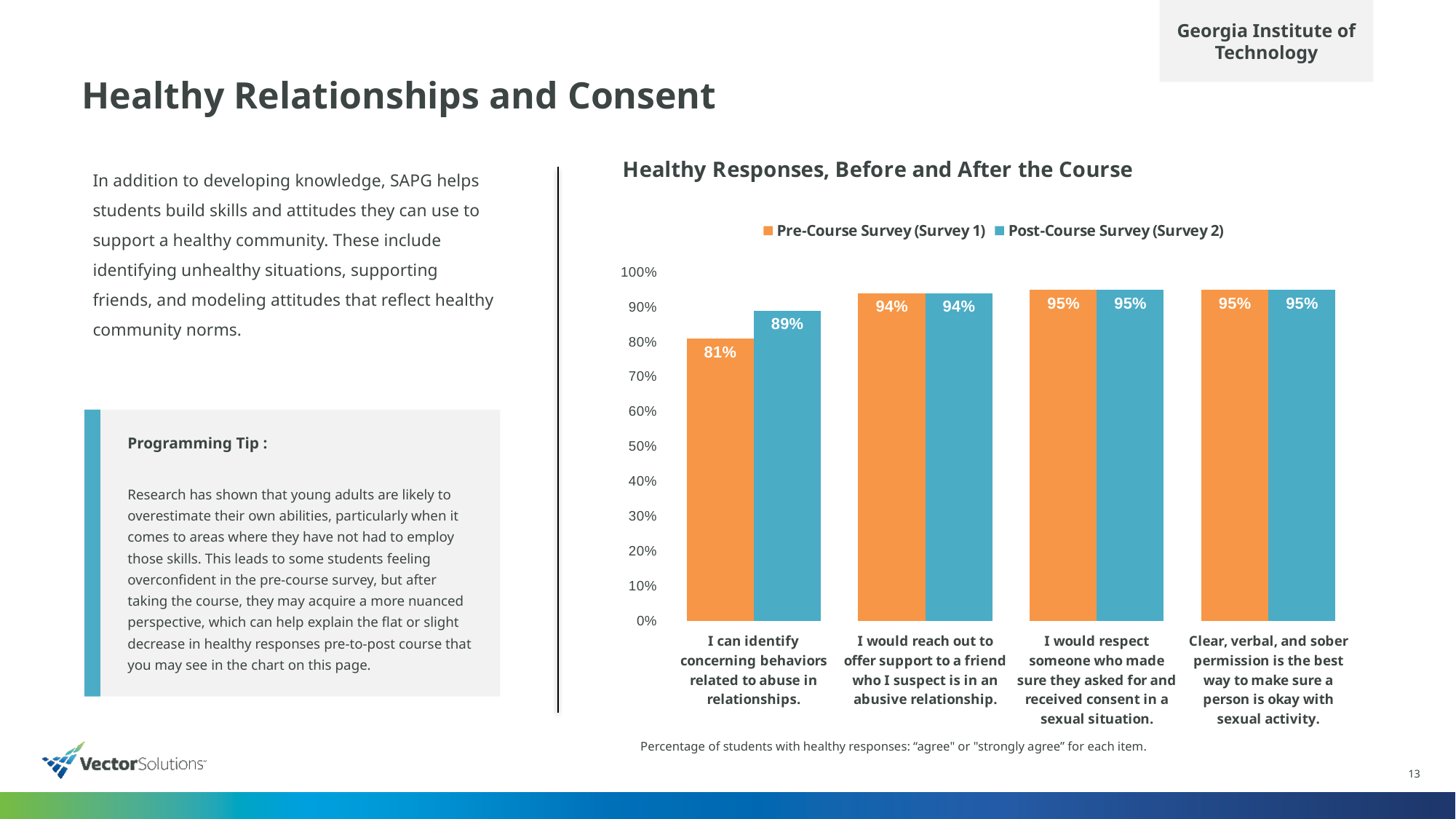
Which colour represents the Post-Course Survey (Survey 2) series in the chart? Blue What kind of chart is shown on the slide? Bar chart For "I can identify concerning behaviors related to abuse in relationships.", which is larger: the Pre-Course Survey value or the Post-Course Survey value? Post-Course Survey (Survey 2) How many categories are shown on the x axis of the chart? 4 What is the Pre-Course Survey (Survey 1) value for "I can identify concerning behaviors related to abuse in relationships."? 81% What is the title of the chart? Healthy Responses, Before and After the Course What is the Post-Course Survey (Survey 2) value for "I would reach out to offer support to a friend who I suspect is in an abusive relationship."? 94% What is the difference between the Post-Course and Pre-Course values for "I can identify concerning behaviors related to abuse in relationships."? 8% What is the Pre-Course Survey (Survey 1) value for "Clear, verbal, and sober permission is the best way to make sure a person is okay with sexual activity."? 95% What is the Post-Course Survey (Survey 2) value for "I can identify concerning behaviors related to abuse in relationships."? 89% How many series does the chart's legend list? 2 Which category has the lowest Pre-Course Survey (Survey 1) value? I can identify concerning behaviors related to abuse in relationships.